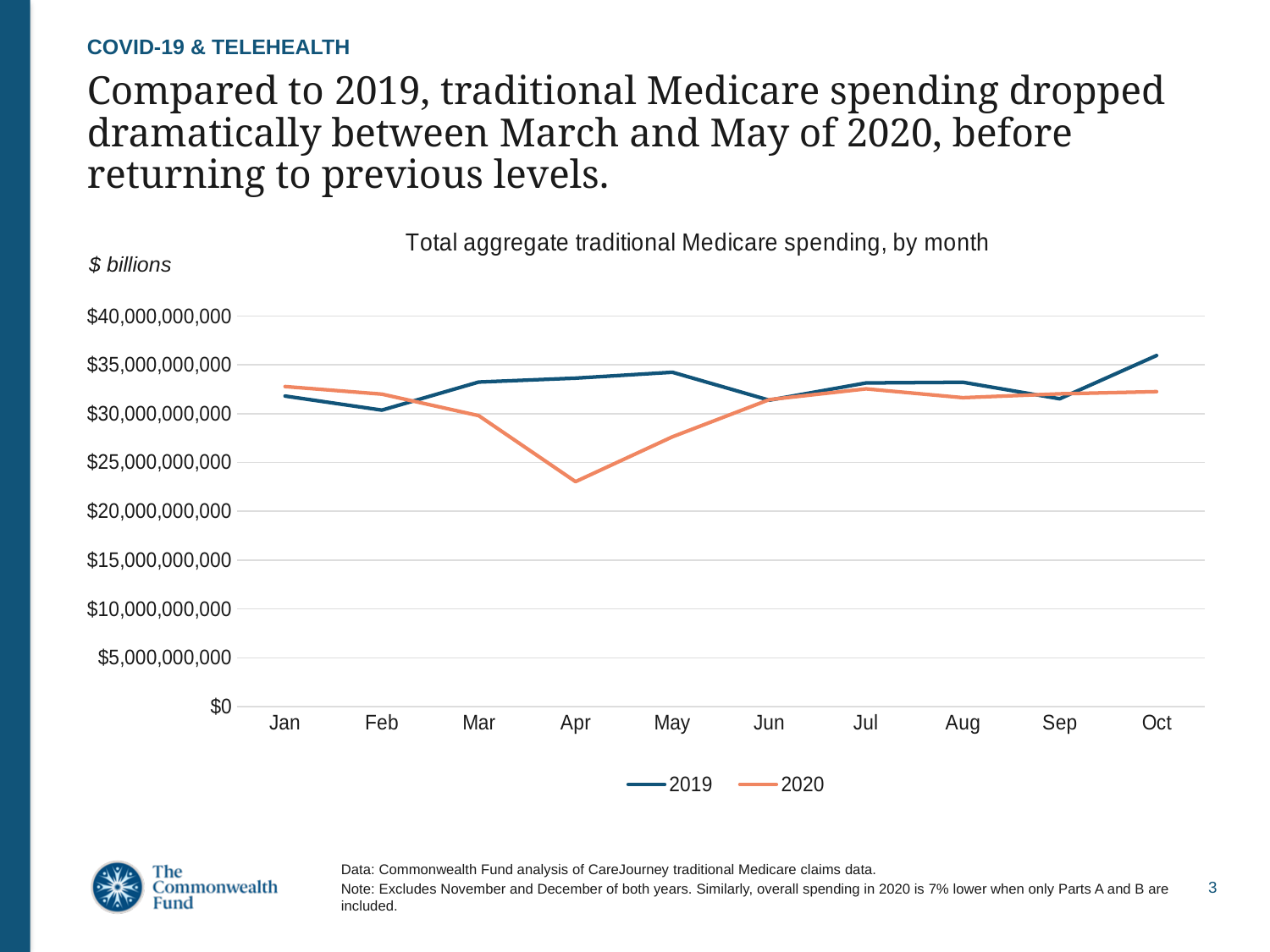
In which month is the 2019 spending lowest? Feb In which month is the 2019 spending highest? Oct How many series does the legend list? 2 In Apr, which series has the higher spending, 2019 or 2020? 2019 Is the 2020 value for Apr greater or less than $20,000,000,000? greater How many months are plotted along the x axis? 10 What kind of chart is shown on the slide? Line chart In which month is the 2020 spending lowest? Apr Does the 2020 line rise or fall from Mar to Apr? Fall What is the title of the chart? Total aggregate traditional Medicare spending, by month Is the 2020 value for Apr greater or less than $25,000,000,000? less Is the 2019 value for Oct greater or less than $35,000,000,000? greater